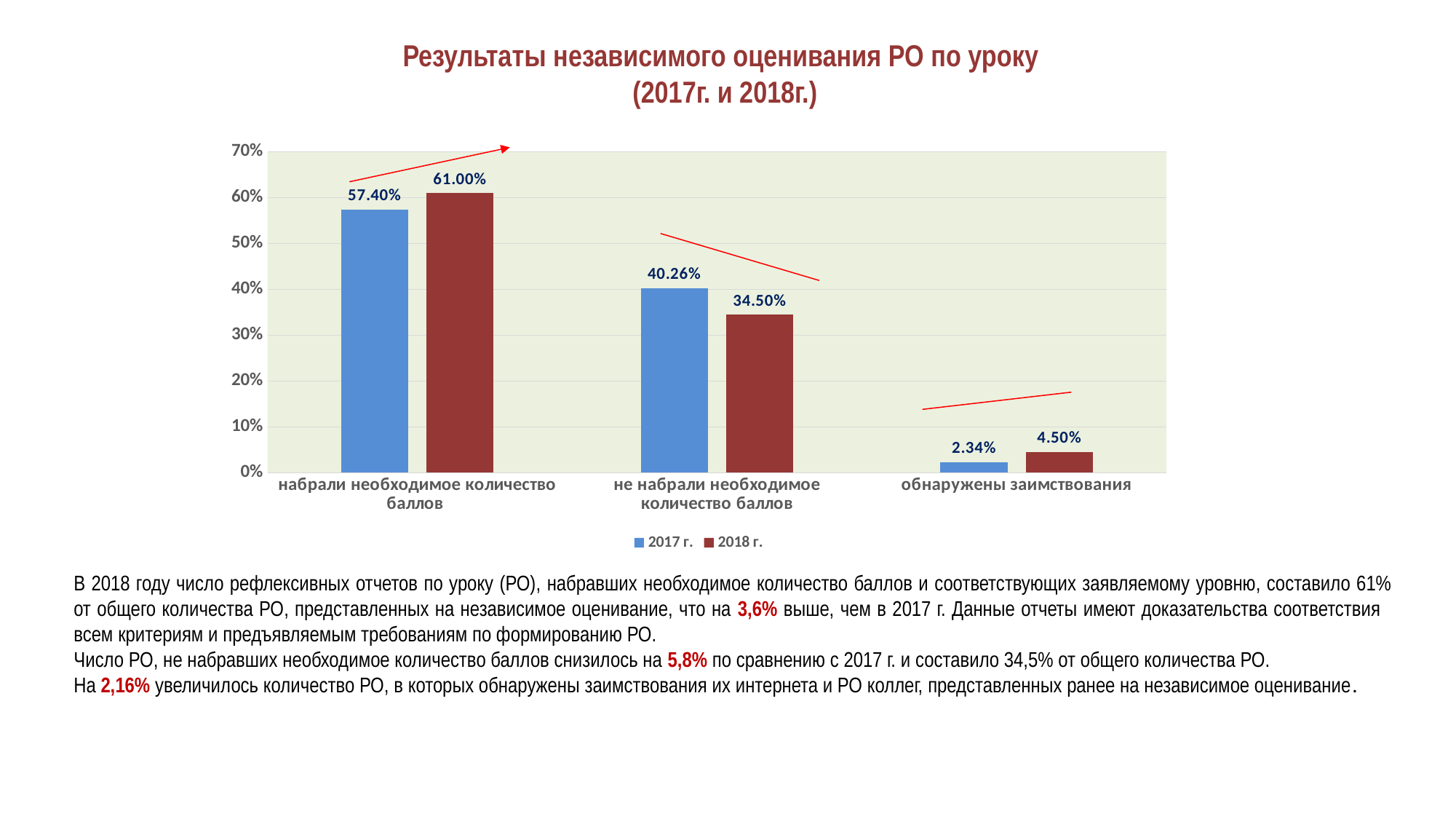
Which category has the highest value for 2018 г.? набрали необходимое количество баллов What is the value for 2017 г. in the category 'набрали необходимое количество баллов'? 57.40% What is the difference between the 2017 г. and 2018 г. values in the category 'не набрали необходимое количество баллов'? 5.76% What kind of chart is shown on the slide? bar chart What colour are the bars for the 2018 г. series? dark red In the category 'обнаружены заимствования', which series has the larger value, 2017 г. or 2018 г.? 2018 г. What is the value for 2018 г. in the category 'не набрали необходимое количество баллов'? 34.50% How many categories are shown on the x axis? 3 What is the difference between the 2018 г. and 2017 г. values in the category 'набрали необходимое количество баллов'? 3.60% What is the value for 2017 г. in the category 'обнаружены заимствования'? 2.34% How many series does the legend list? 2 Which category has the lowest value for 2017 г.? обнаружены заимствования